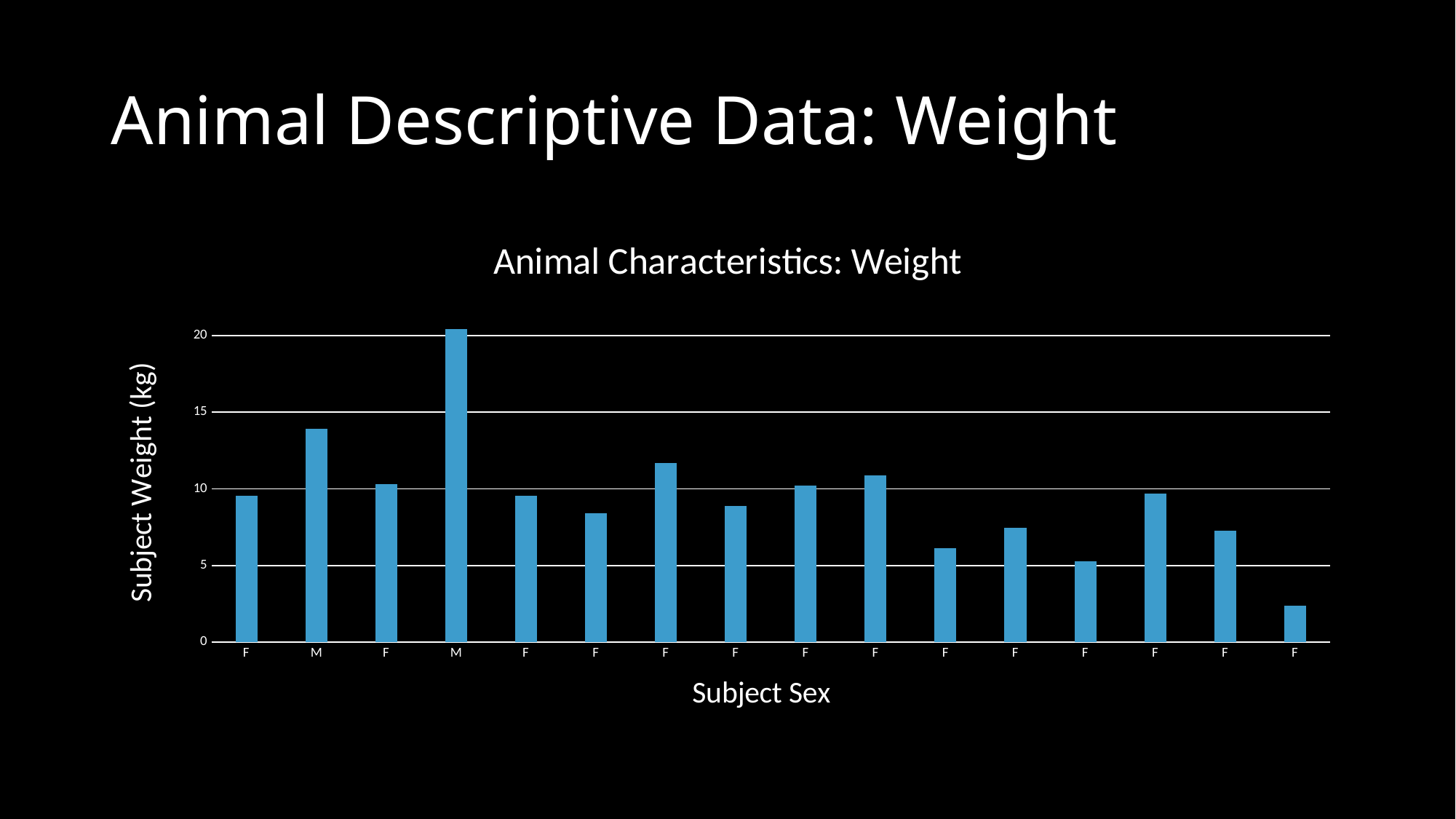
Is the value for the seventh bar (F) greater or less than 10? greater Is the value for the last bar (F) greater or less than 5? less Which bar is the tallest in the chart? the fourth bar (M) Which bar is the shortest in the chart? the last bar (F) Is the value for the second bar (M) greater or less than 10? greater How many bars are plotted in the chart? 16 What is the label of the vertical axis? Subject Weight (kg) Which is larger, the second bar (M) or the third bar (F)? the second bar (M) How many bars are labelled M on the x axis? 2 What is the title of the chart? Animal Characteristics: Weight What kind of chart is shown on the slide? bar chart